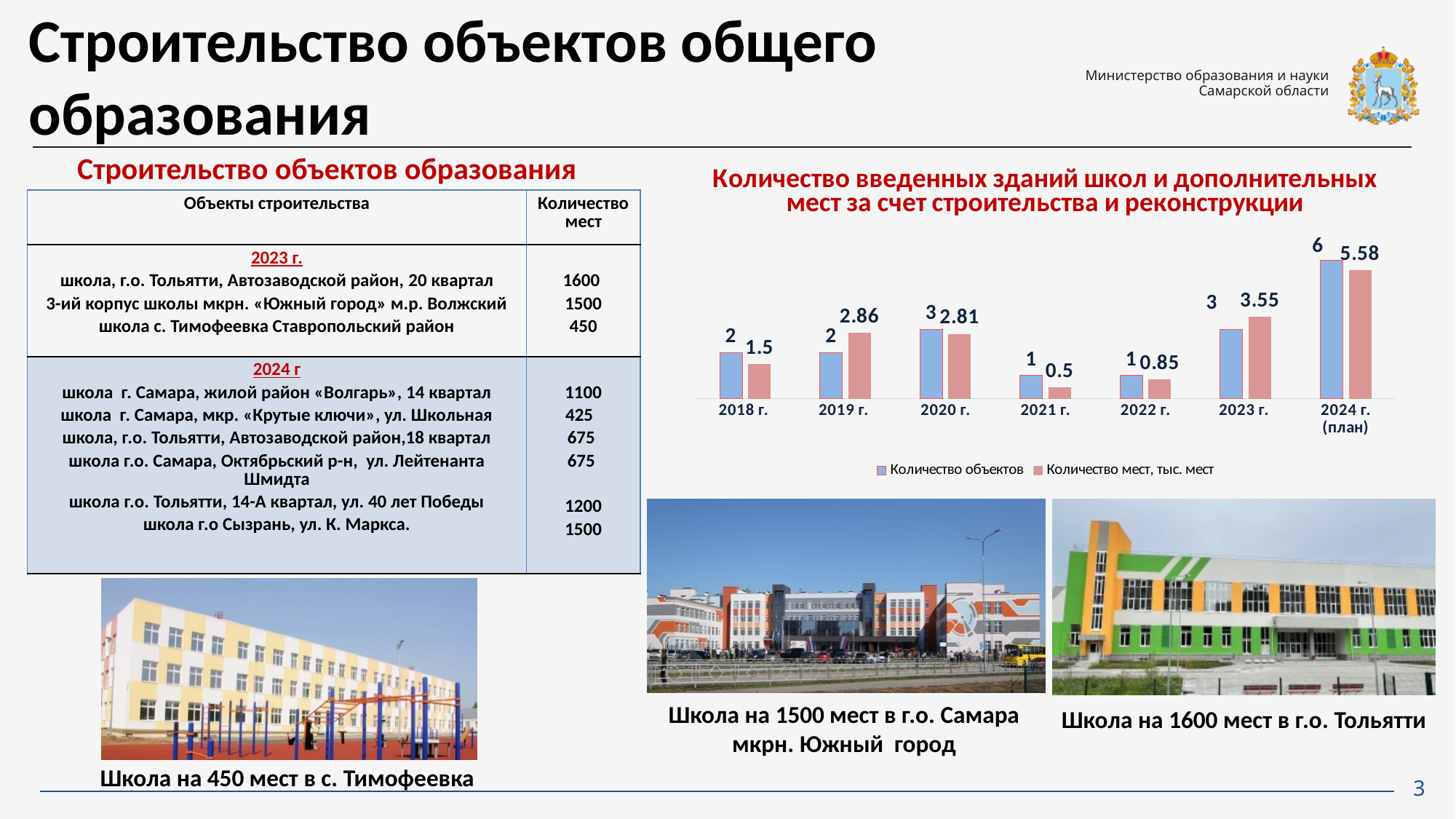
What colour are the bars for "Количество объектов" in the chart? blue What is the value of "Количество мест, тыс. мест" for 2021 г.? 0.5 What is the value of "Количество мест, тыс. мест" for 2019 г.? 2.86 Which year has the lowest value of "Количество мест, тыс. мест"? 2021 г. Which is larger: "Количество мест, тыс. мест" for 2019 г. or for 2020 г.? 2019 г. How many year categories are shown on the x axis of the chart? 7 What is the value of "Количество объектов" for 2024 г. (план)? 6 How does "Количество объектов" change from 2022 г. to 2024 г. (план)? rises Which year has the highest value of "Количество мест, тыс. мест"? 2024 г. (план) What is the difference in "Количество мест, тыс. мест" between 2024 г. (план) and 2023 г.? 2.03 What kind of chart is shown on the slide? bar chart How many series does the chart legend list? 2